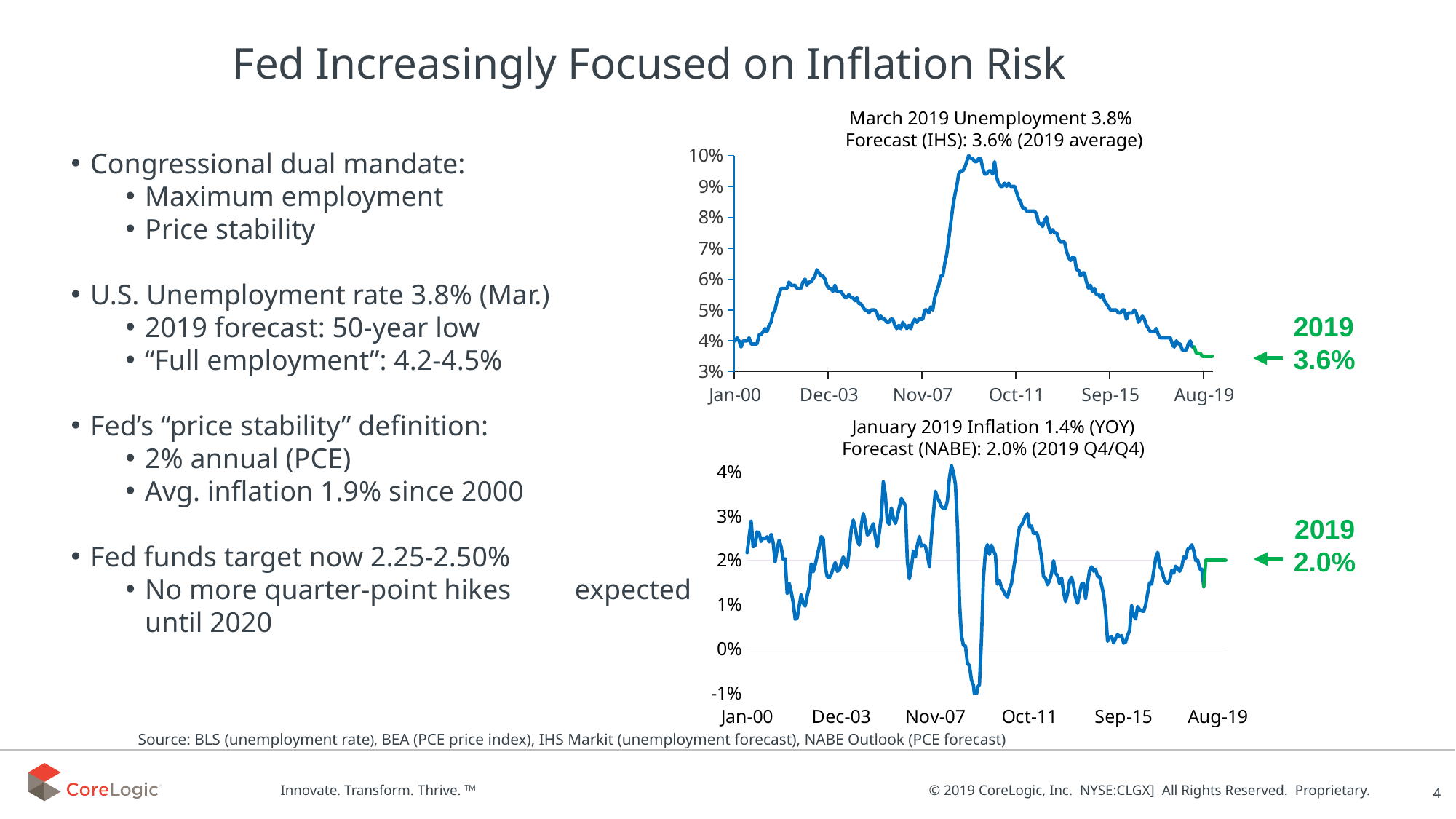
On the top unemployment chart, is the peak value of the line (around 2009-2010) greater or less than 9%? greater What kind of chart is the top chart titled "March 2019 Unemployment 3.8%"? line chart How many labels are shown on the x axis of the top unemployment chart? 6 What is the difference between the March 2019 unemployment rate (3.8%) and the IHS 2019 forecast (3.6%) shown on the top chart? 0.2 percentage points What is the lowest y-axis label on the bottom inflation chart? -1% According to the title of the top chart, what was the March 2019 unemployment rate? 3.8% On the bottom inflation chart, what 2019 forecast value is labeled in green at the right end of the line? 2.0% On the top unemployment chart, which is larger: the value at Jan-00 or the value at Dec-03? Dec-03 On the bottom inflation chart, is the lowest value of the line (around 2009) greater or less than 0%? less On the top unemployment chart, does the line rise or fall between Oct-11 and Aug-19? fall On the top unemployment chart, what 2019 forecast value is labeled in green at the right end of the line? 3.6% According to the title of the bottom chart, what was January 2019 inflation (YOY)? 1.4%